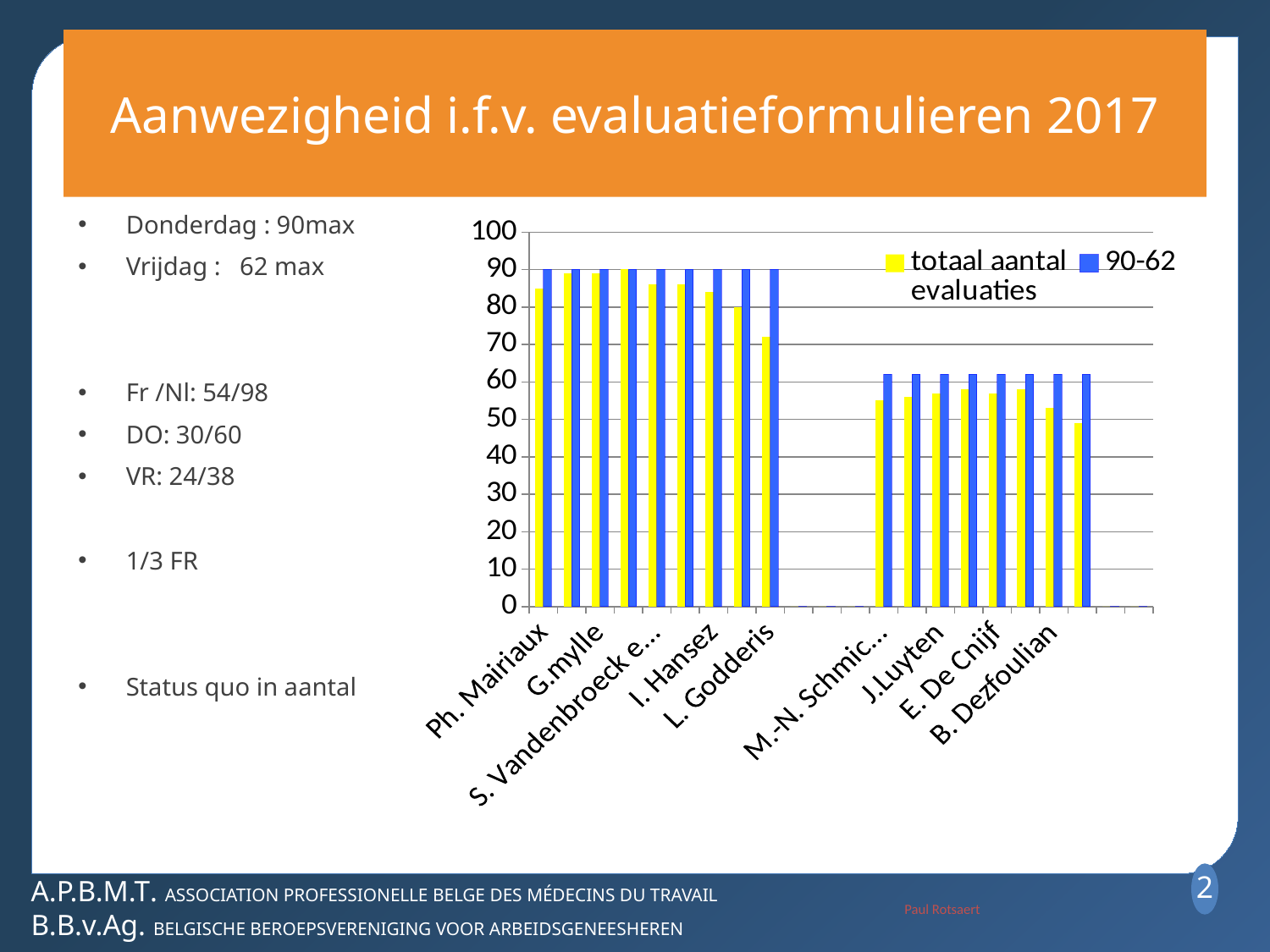
Is the 'totaal aantal evaluaties' value for Ph. Mairiaux greater or less than 90? less Is the 'totaal aantal evaluaties' value for L. Godderis greater or less than 80? less Which has the larger 'totaal aantal evaluaties' value: G.mylle or J.Luyten? G.mylle What is the value of the '90-62' bar for I. Hansez? 90 Which colour represents the series 'totaal aantal evaluaties'? yellow How many series does the chart legend list? 2 What kind of chart is shown on the slide? bar chart What are the two series named in the chart legend? totaal aantal evaluaties and 90-62 Is the 'totaal aantal evaluaties' value for B. Dezfoulian greater or less than 60? less What is the value of the '90-62' bar for Ph. Mairiaux? 90 For Ph. Mairiaux, which is larger: the 'totaal aantal evaluaties' bar or the '90-62' bar? 90-62